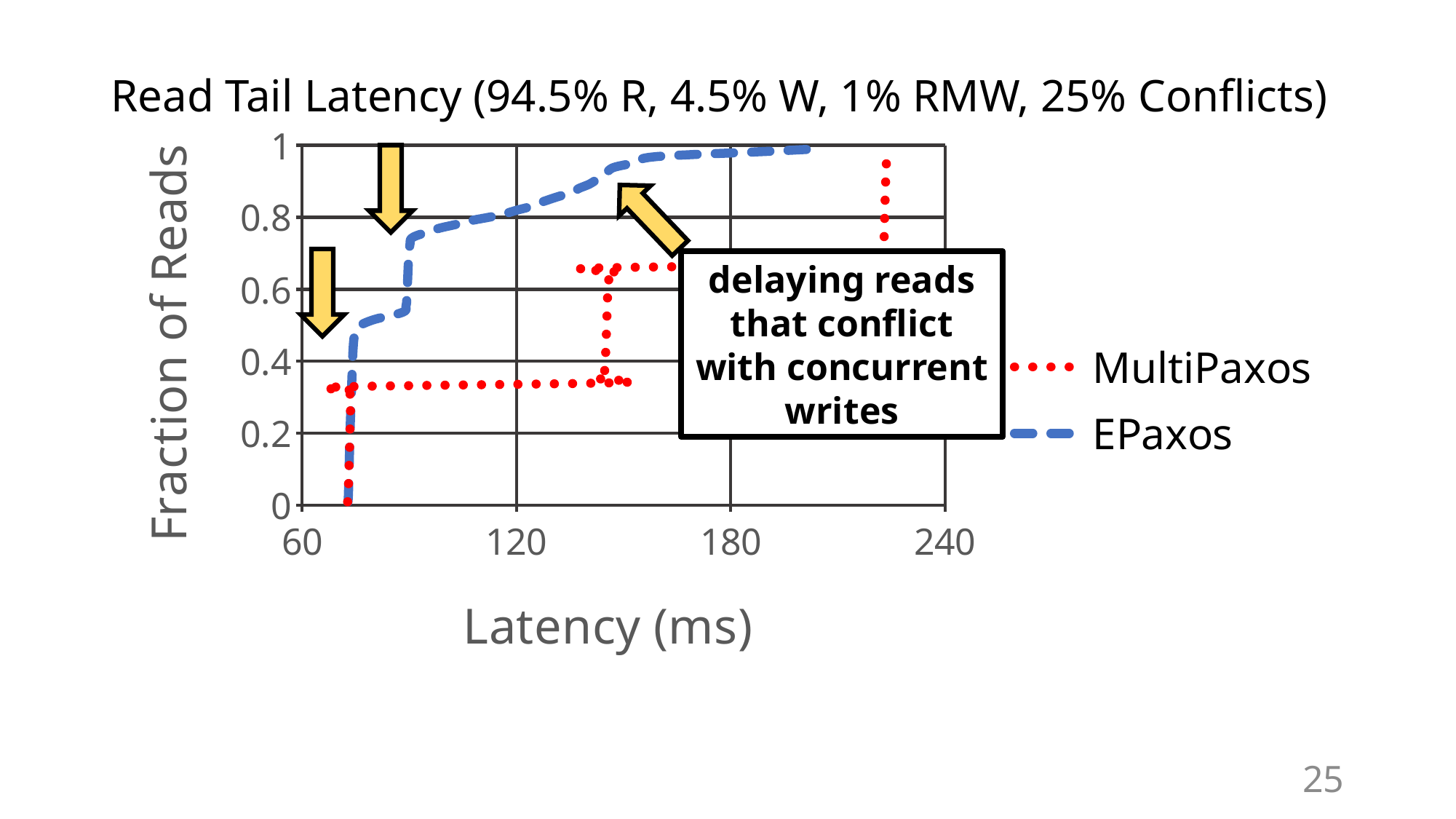
At a latency of 180 ms, is the fraction of reads for EPaxos greater or less than 0.8? greater At a latency of 120 ms, is the fraction of reads for EPaxos greater or less than 0.6? greater What is the title of the chart? Read Tail Latency (94.5% R, 4.5% W, 1% RMW, 25% Conflicts) Do the values of the EPaxos series rise or fall as latency increases along the x axis? rise What does the annotation box on the chart say? delaying reads that conflict with concurrent writes At a latency of 120 ms, is the fraction of reads for MultiPaxos greater or less than 0.4? less How many series does the legend list? 2 At a latency of 120 ms, which series has the higher fraction of reads, MultiPaxos or EPaxos? EPaxos At a latency of 180 ms, which series has the lower fraction of reads, MultiPaxos or EPaxos? MultiPaxos Which series reaches a fraction of reads of 1 at a lower latency, MultiPaxos or EPaxos? EPaxos What kind of chart is shown on the slide? line chart